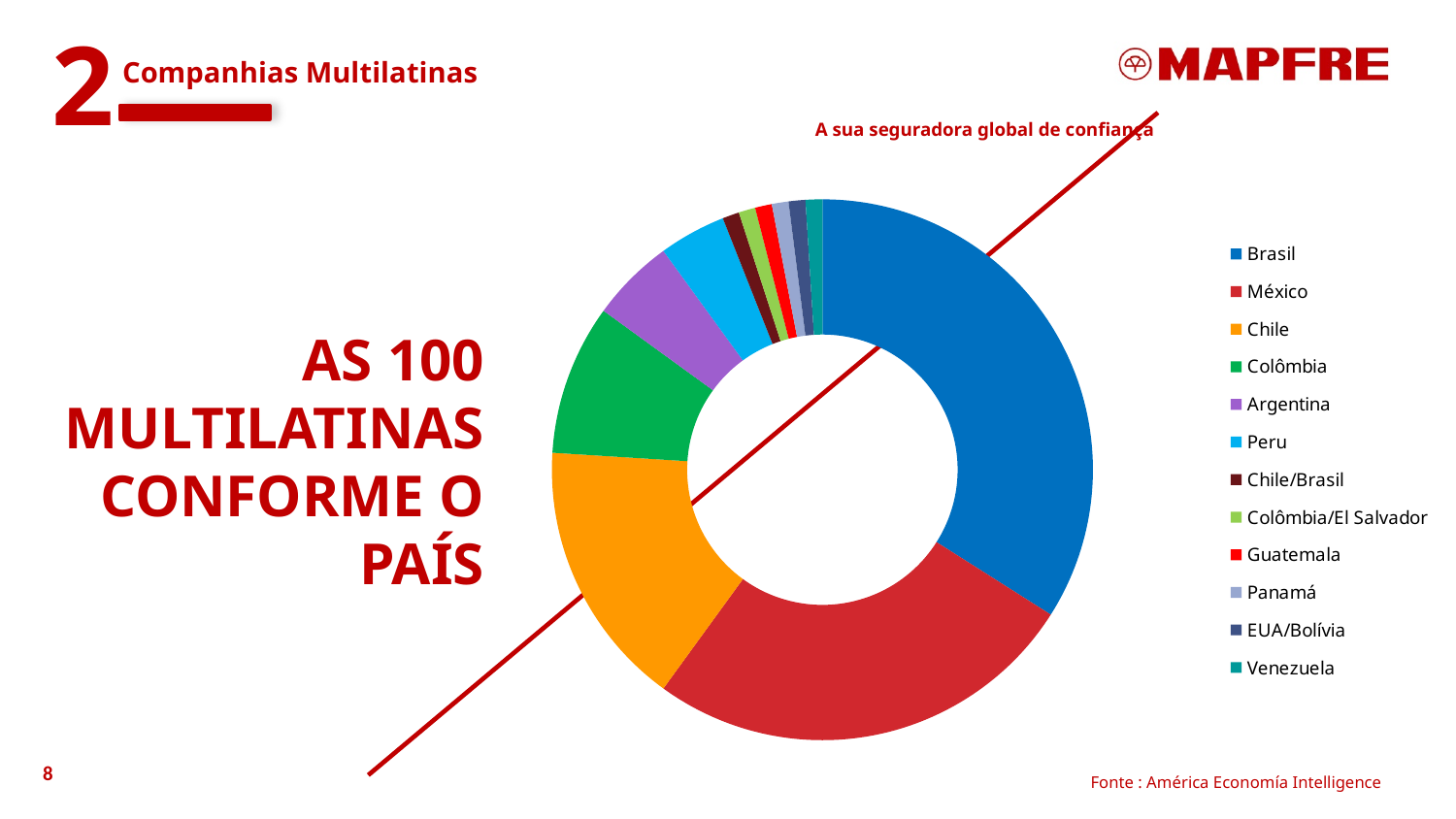
What kind of chart is shown on the slide? Doughnut (pie) chart Which country has the largest slice in the chart? Brasil Which slice is larger, Colômbia or Argentina? Colômbia What colour represents Brasil in the chart? Blue Which slice is larger, Chile or Colômbia? Chile Which slice is larger, Argentina or Guatemala? Argentina Which legend entry is listed last in the chart's legend? Venezuela How many countries or country groups does the legend of the chart list? 12